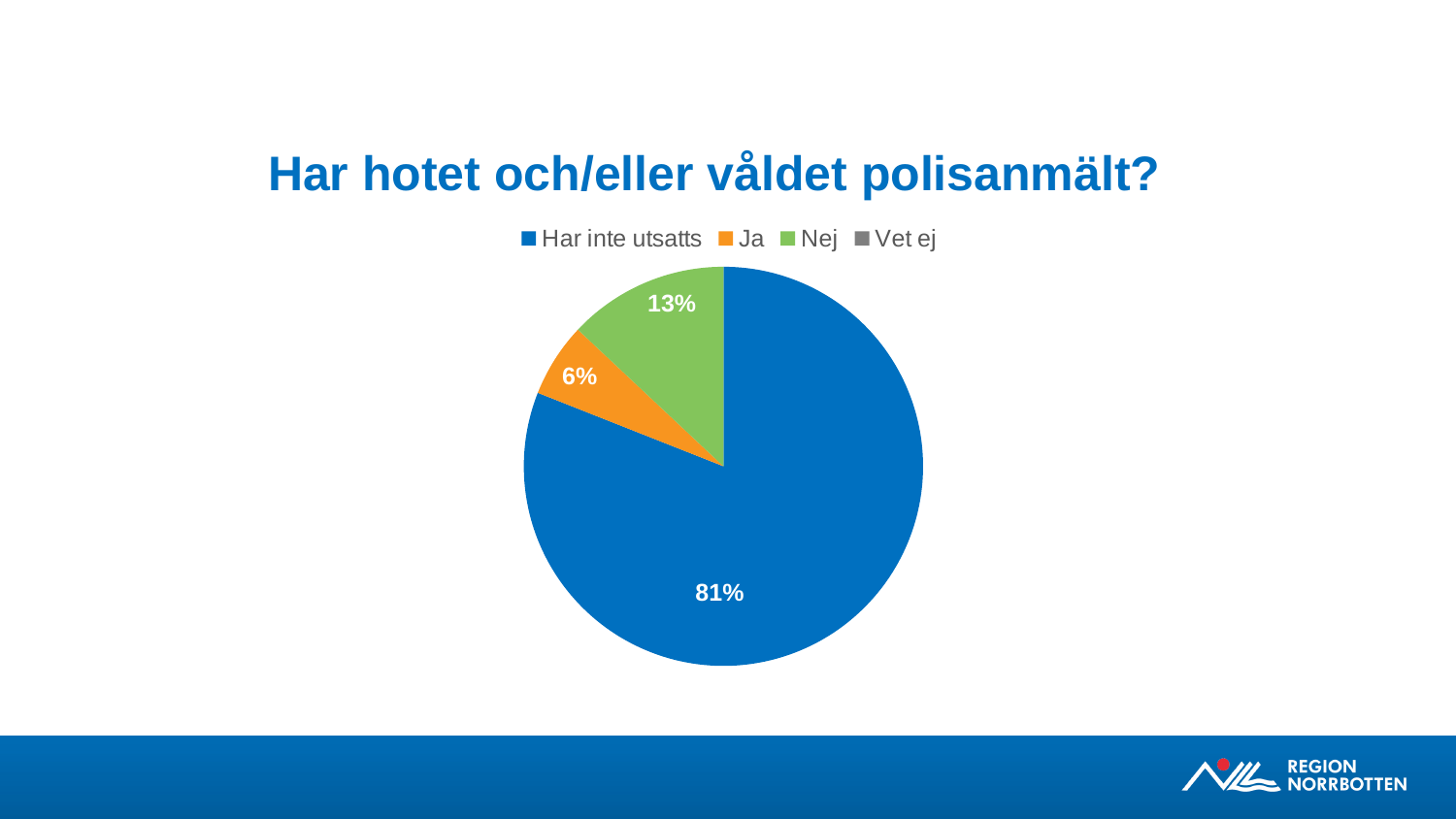
Which of the labelled slices is the smallest? Ja What share of the pie is labelled for "Nej"? 13% Which slice is larger, "Ja" or "Nej"? Nej What kind of chart is shown on the slide? pie chart What is the difference in percentage points between the "Nej" slice and the "Ja" slice? 7 What is the difference in percentage points between the "Har inte utsatts" slice and the "Nej" slice? 68 What is the title of the chart? Har hotet och/eller våldet polisanmält? How many entries does the legend list? 4 What share of the pie is labelled for "Ja"? 6% What share of the pie is labelled for "Har inte utsatts"? 81% What colour is the "Ja" slice? orange Which category has the largest slice of the pie? Har inte utsatts